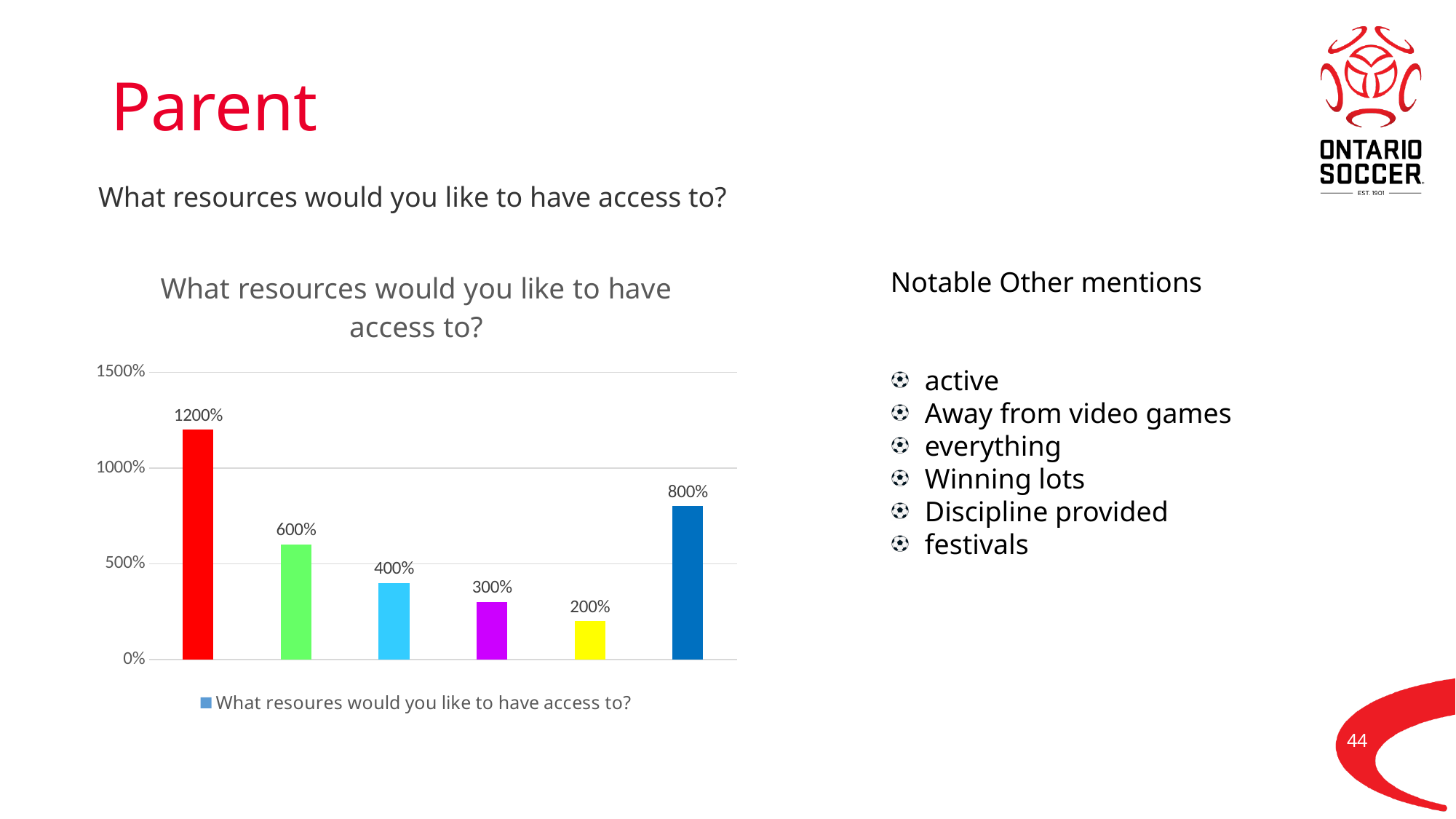
What type of chart is shown on the slide? bar chart Which bar has the lowest value? the yellow bar, 200% Which bar has the highest value? the first (red) bar, 1200% What is the value shown on the purple bar? 300% What is the value shown on the yellow bar? 200% What is the value shown on the last (dark blue) bar? 800% How many series does the chart legend list? 1 What is the difference between the red bar (1200%) and the dark blue bar (800%)? 400% How many bars are plotted in the chart? 6 Which is larger, the green bar or the light blue bar? the green bar (600%) What is the title of the chart? What resources would you like to have access to? What is the value shown on the first (red) bar? 1200%